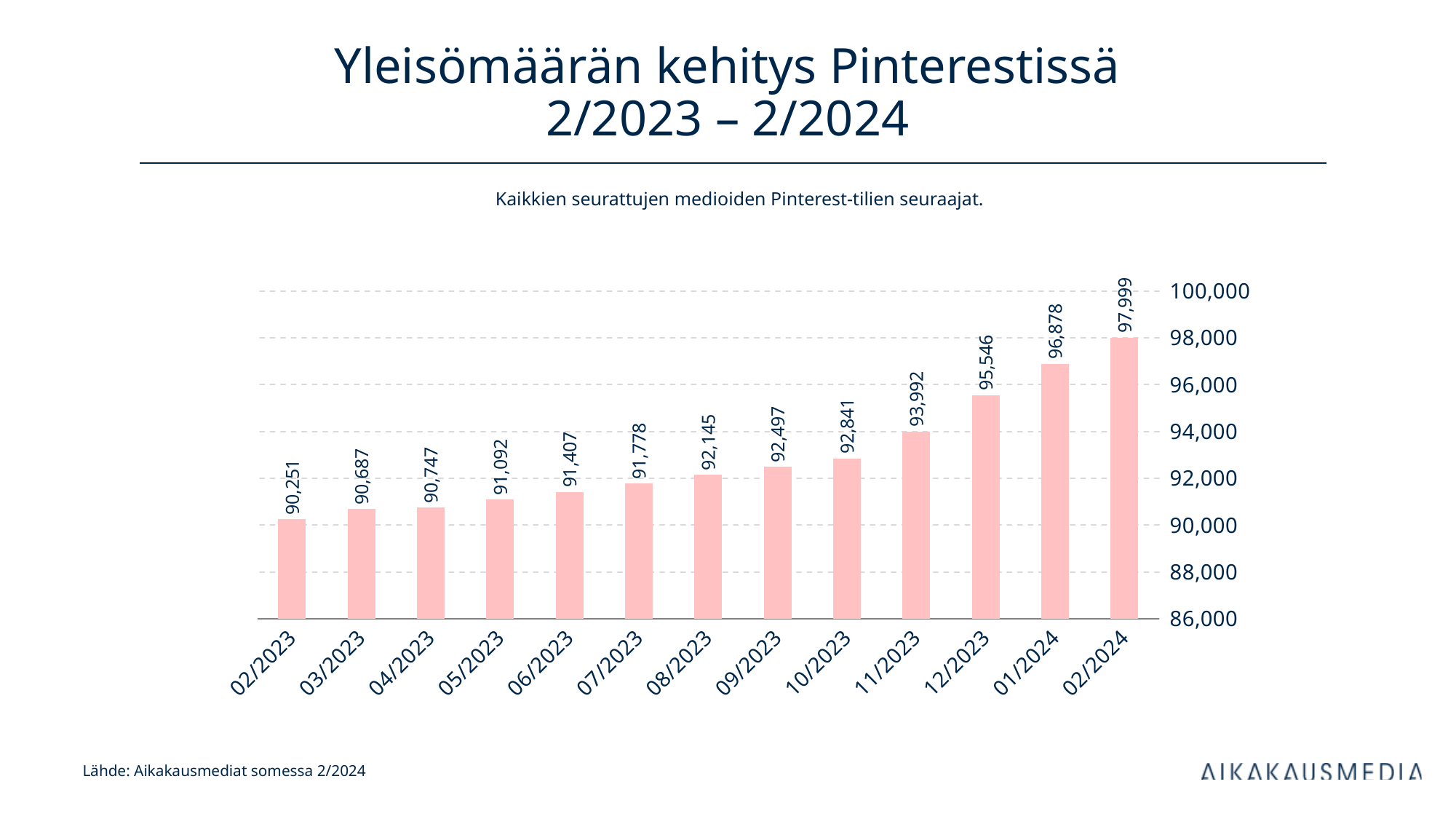
What is the value for 02/2023? 90,251 What is the value for 09/2023? 92,497 What is the value for 01/2024? 96,878 How many months are shown on the x axis? 13 What is the difference between the values for 02/2024 and 02/2023? 7,748 What kind of chart is shown on the slide? bar chart Which month has the highest value? 02/2024 Do the values rise or fall from 02/2023 to 02/2024? rise What is the difference between the values for 12/2023 and 11/2023? 1,554 Which is larger, the value for 07/2023 or the value for 10/2023? 10/2023 Is the value for 12/2023 greater or less than 94,000? greater Which month has the lowest value? 02/2023